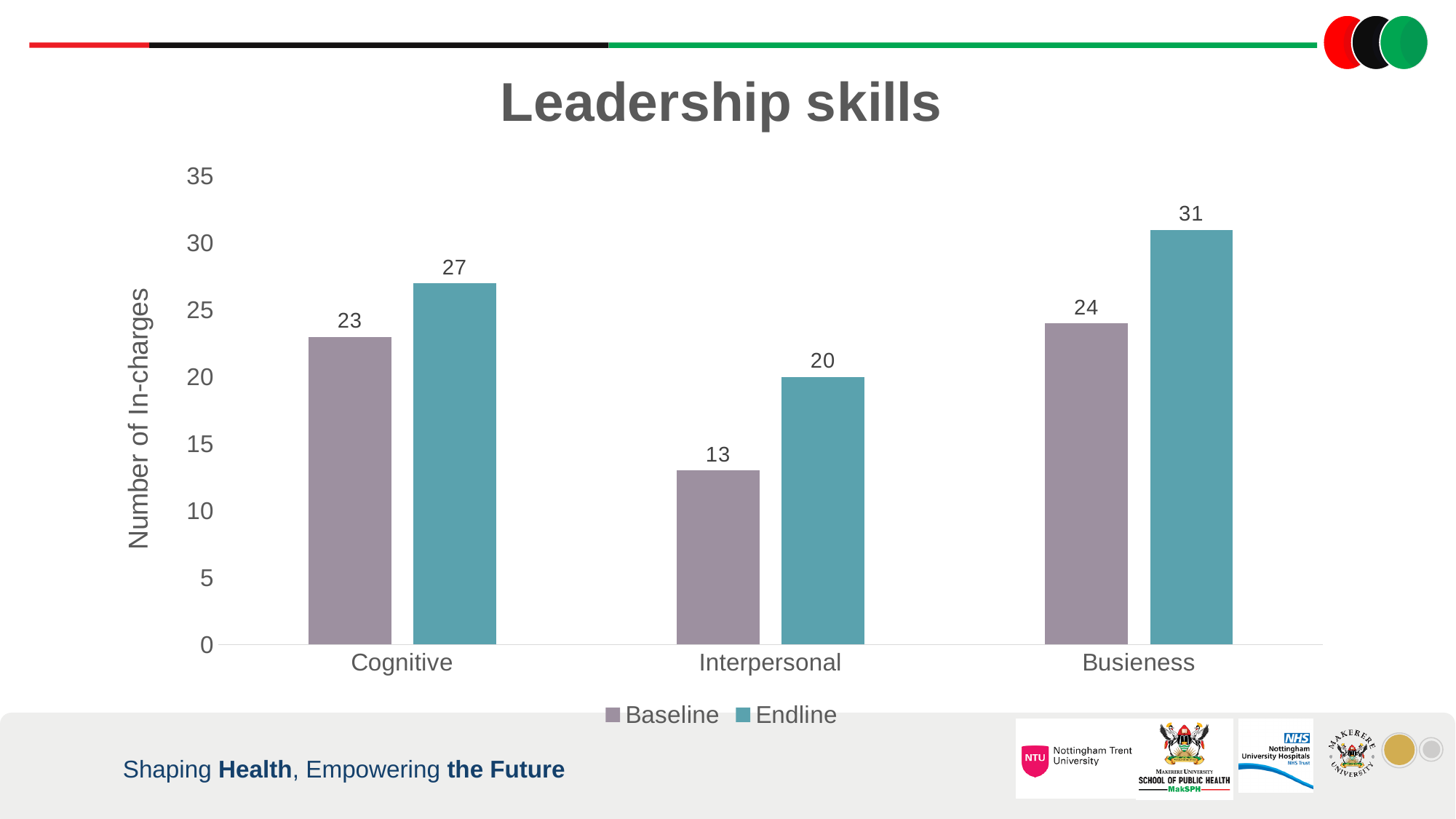
How many categories are shown on the x axis? 3 Which category has the lowest Baseline value? Interpersonal What is the difference between the Endline and Baseline values for Interpersonal? 7 Is the Endline value for Cognitive greater or less than 25? greater Which is larger, the Baseline value for Cognitive or the Baseline value for Busieness? Busieness What is the Baseline value for Cognitive? 23 Which category has the highest Endline value? Busieness What is the Endline value for Interpersonal? 20 What is the difference between the Endline and Baseline values for Busieness? 7 How many series does the legend list? 2 What is the Endline value for Busieness? 31 What kind of chart is shown on the slide? bar chart